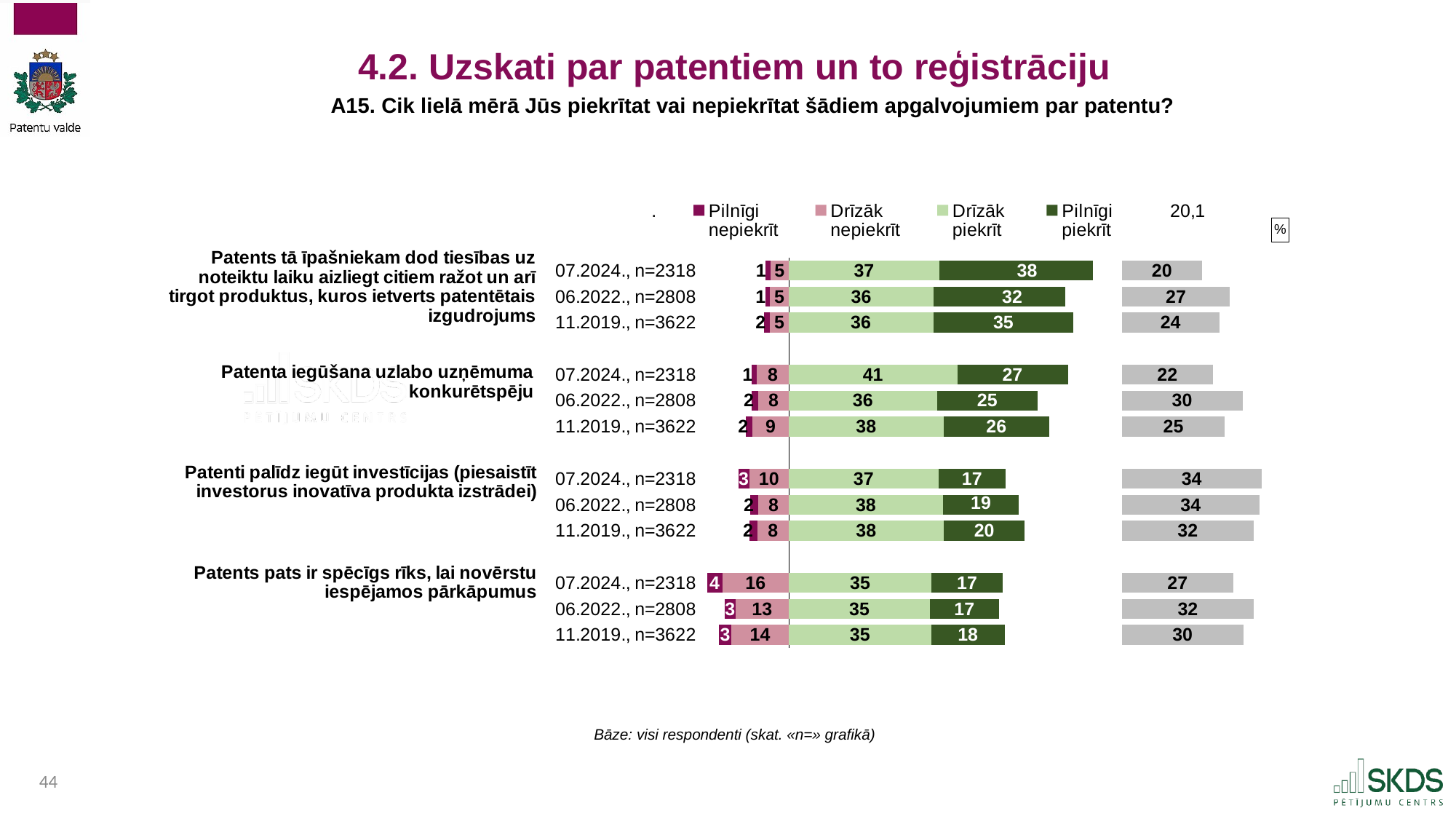
What is the "Drīzāk nepiekrīt" value for "Patents pats ir spēcīgs rīks, lai novērstu iespējamos pārkāpumus" in 07.2024., n=2318? 16 What is the value of the grey bar for "Patenti palīdz iegūt investīcijas (piesaistīt investorus inovatīva produkta izstrādei)" in 07.2024., n=2318? 34 Among the 07.2024., n=2318 bars, which statement has the highest "Pilnīgi piekrīt" value? Patents tā īpašniekam dod tiesības uz noteiktu laiku aizliegt citiem ražot un arī tirgot produktus, kuros ietverts patentētais izgudrojums How many statements are shown in the chart? 4 What kind of chart is shown on the slide? Stacked bar chart Among the 07.2024., n=2318 bars, which statement has the lowest "Drīzāk piekrīt" value? Patents pats ir spēcīgs rīks, lai novērstu iespējamos pārkāpumus For "Patenti palīdz iegūt investīcijas (piesaistīt investorus inovatīva produkta izstrādei)", which wave has the larger "Drīzāk piekrīt" value: 07.2024., n=2318 or 06.2022., n=2808? 06.2022., n=2808 For "Patents tā īpašniekam dod tiesības..." in 07.2024., n=2318, what is the combined value of "Drīzāk piekrīt" and "Pilnīgi piekrīt"? 75 How many series does the legend list? 4 What is the "Drīzāk piekrīt" value for "Patenta iegūšana uzlabo uzņēmuma konkurētspēju" in 07.2024., n=2318? 41 For "Patents tā īpašniekam dod tiesības..." how much higher is the "Pilnīgi piekrīt" value in 07.2024., n=2318 than in 06.2022., n=2808? 6 What is the "Pilnīgi piekrīt" value for "Patents tā īpašniekam dod tiesības uz noteiktu laiku aizliegt citiem ražot un arī tirgot produktus, kuros ietverts patentētais izgudrojums" in 07.2024., n=2318? 38